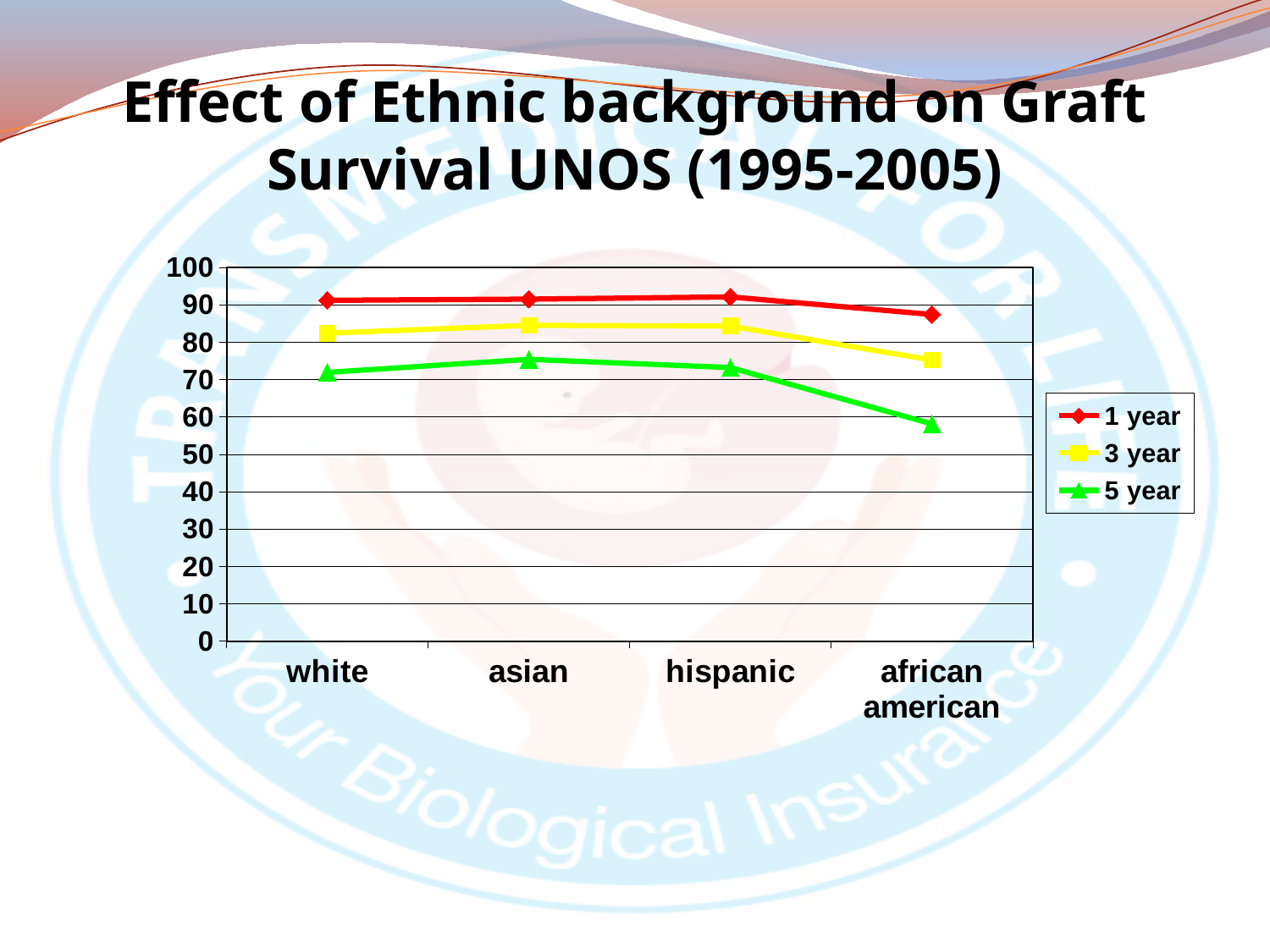
Which category has the lowest value for the 5 year series? african american How many series does the legend list? 3 Is the 5 year value for african american greater or less than 70? less Is the 3 year value for african american greater or less than 80? less Is the 1 year value for white greater or less than 80? greater How many ethnic categories are plotted along the x axis? 4 What kind of chart is shown on the slide? line chart Which category has the lowest value for the 3 year series? african american For the hispanic category, which series has the larger value, 1 year or 5 year? 1 year What colour is the line for the 3 year series? yellow Does the 5 year series rise or fall from hispanic to african american? fall